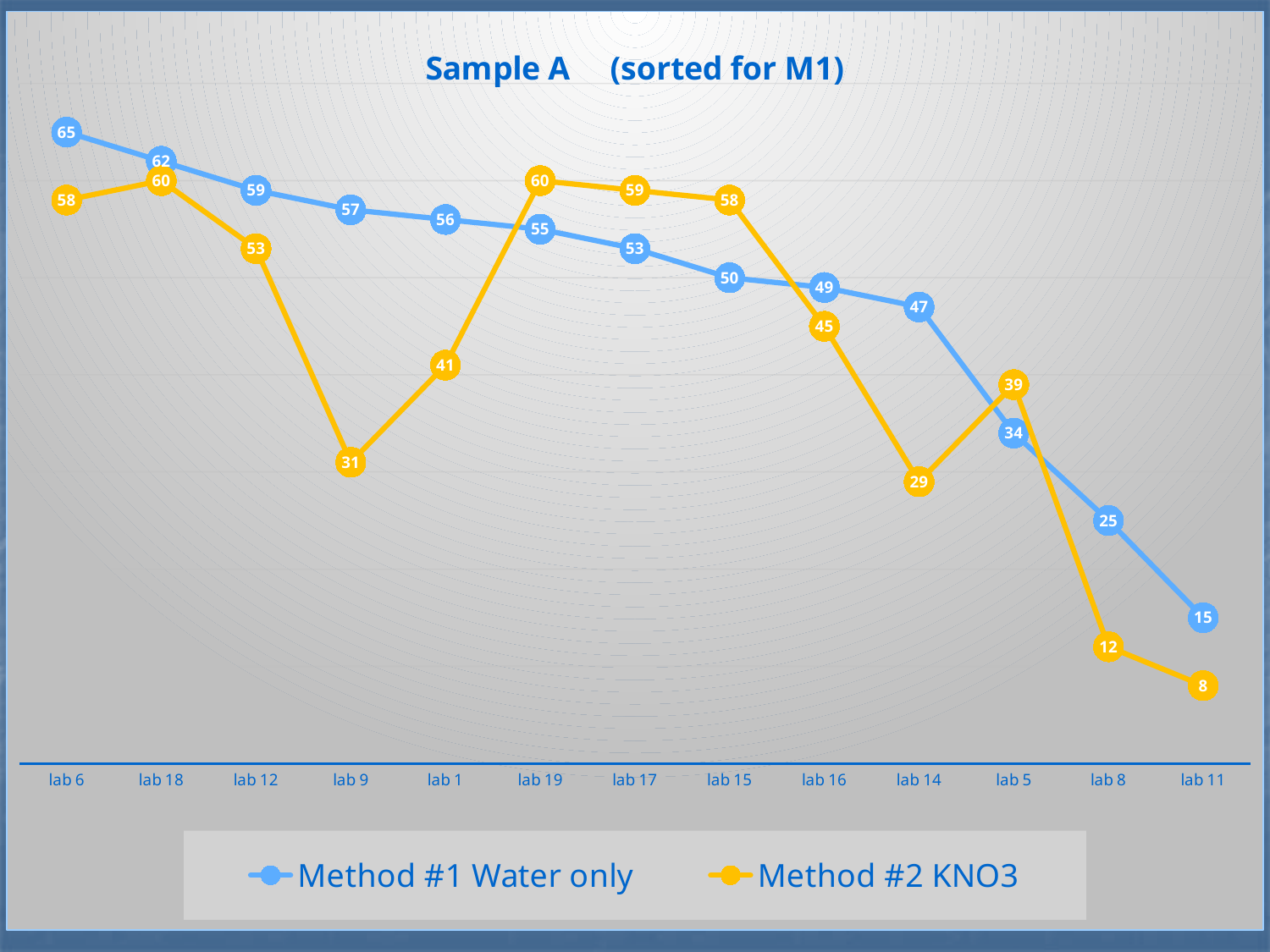
Does the Method #1 Water only series rise or fall from lab 6 to lab 11? fall How many labs are shown on the x axis? 13 What is the Method #1 Water only value for lab 9? 57 What is the Method #2 KNO3 value for lab 14? 29 What is the difference between the Method #1 Water only and Method #2 KNO3 values for lab 9? 26 How many series does the legend list? 2 For lab 19, which series has the larger value, Method #1 Water only or Method #2 KNO3? Method #2 KNO3 Which lab has the highest Method #1 Water only value? lab 6 Which lab has the lowest Method #2 KNO3 value? lab 11 What is the title of the chart? Sample A (sorted for M1) What type of chart is shown on the slide? line chart What colour is the line for Method #2 KNO3? yellow